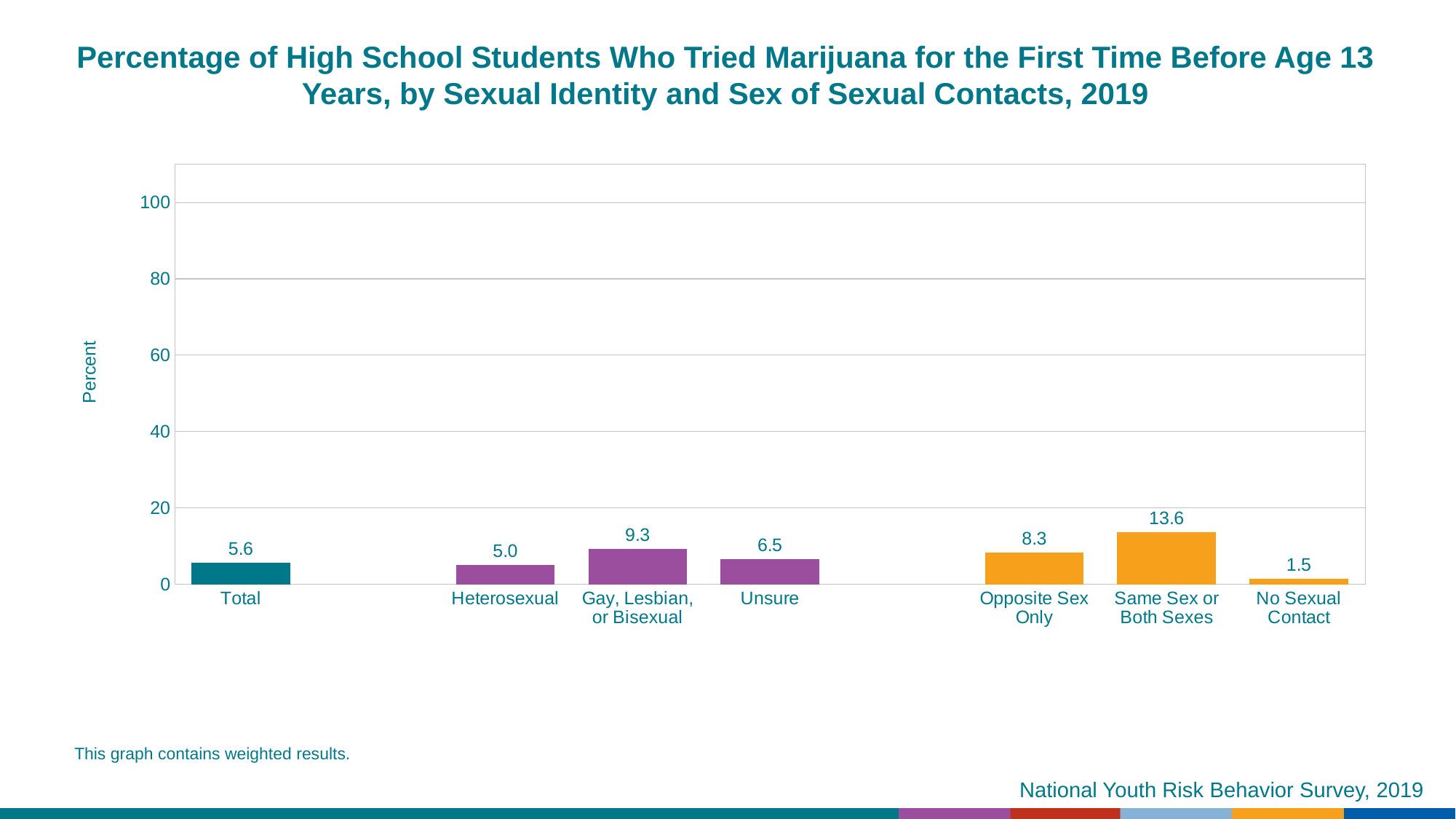
What is the value for Gay, Lesbian, or Bisexual students? 9.3 What is the difference between the values for Gay, Lesbian, or Bisexual and Heterosexual? 4.3 What is the value for No Sexual Contact? 1.5 What is the value for Total? 5.6 What kind of chart is shown on the slide? bar chart What is the value for Same Sex or Both Sexes? 13.6 Which category has the lowest value? No Sexual Contact What is the label of the y axis? Percent Which is larger, the value for Unsure or the value for Opposite Sex Only? Opposite Sex Only Which category has the highest value? Same Sex or Both Sexes How many categories are shown on the chart? 7 Is the value for Same Sex or Both Sexes greater or less than 20? less